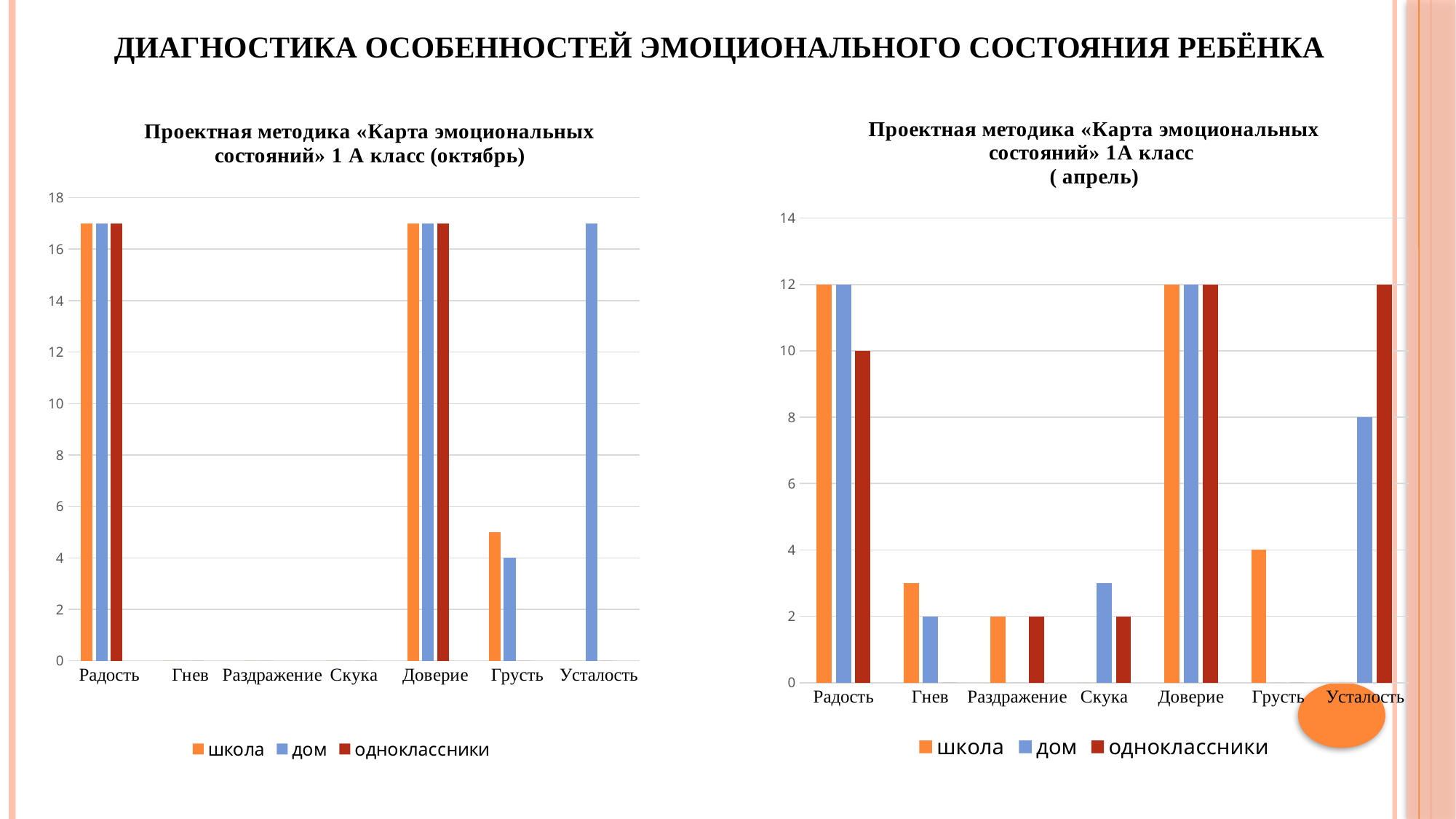
In the right chart (апрель), what is the difference between одноклассники and дом in the Усталость category? 4 In the left chart (октябрь), which series has the higher value for Грусть, школа or дом? школа In the left chart (октябрь), is the value for школа in the Радость category greater or less than 16? greater In the right chart (апрель), what is the value for дом in the Усталость category? 8 In the right chart (апрель), what is the value for одноклассники in the Радость category? 10 In the right chart (апрель), what is the value for школа in the Грусть category? 4 What kind of chart is the left chart (октябрь)? bar chart How many categories are shown on the x axis of the left chart (октябрь)? 7 How many series does the legend of the right chart (апрель) list? 3 In the right chart (апрель), is the value for дом in the Скука category greater or less than 2? greater In the right chart (апрель), which series has the lowest value in the Радость category? одноклассники In the left chart (октябрь), what is the value for дом in the Грусть category? 4